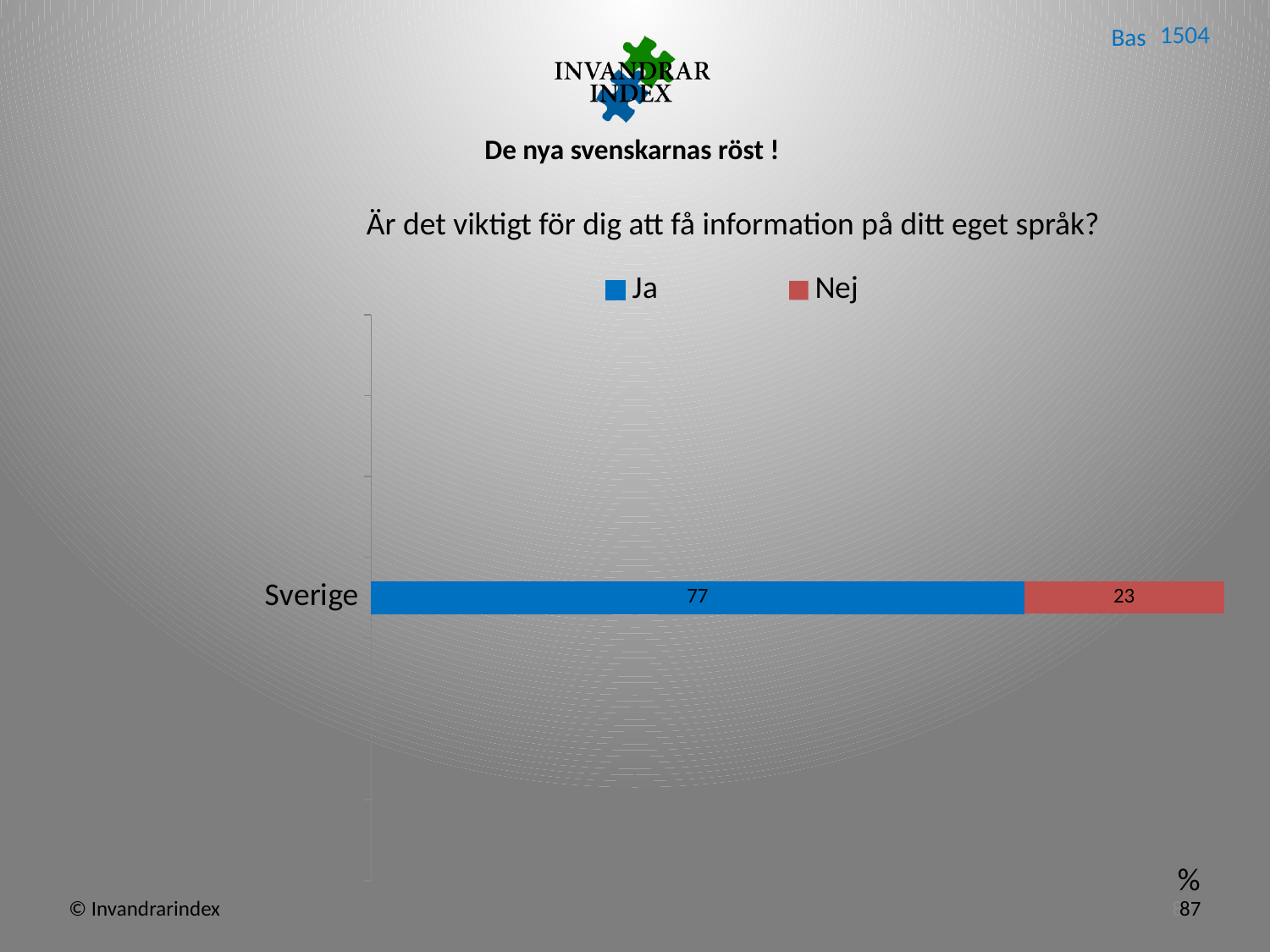
What is the title of the chart? Är det viktigt för dig att få information på ditt eget språk? How many categories are shown on the chart? 1 What kind of chart is shown on the slide? Stacked bar chart What is the name of the category shown on the chart? Sverige What is the value for Ja for Sverige? 77 What is the value for Nej for Sverige? 23 What is the difference between the Ja and Nej values for Sverige? 54 What is the total of the stacked bar for Sverige? 100 Which colour represents Nej in the chart? Red Which series has the larger value for Sverige, Ja or Nej? Ja How many series does the legend list? 2